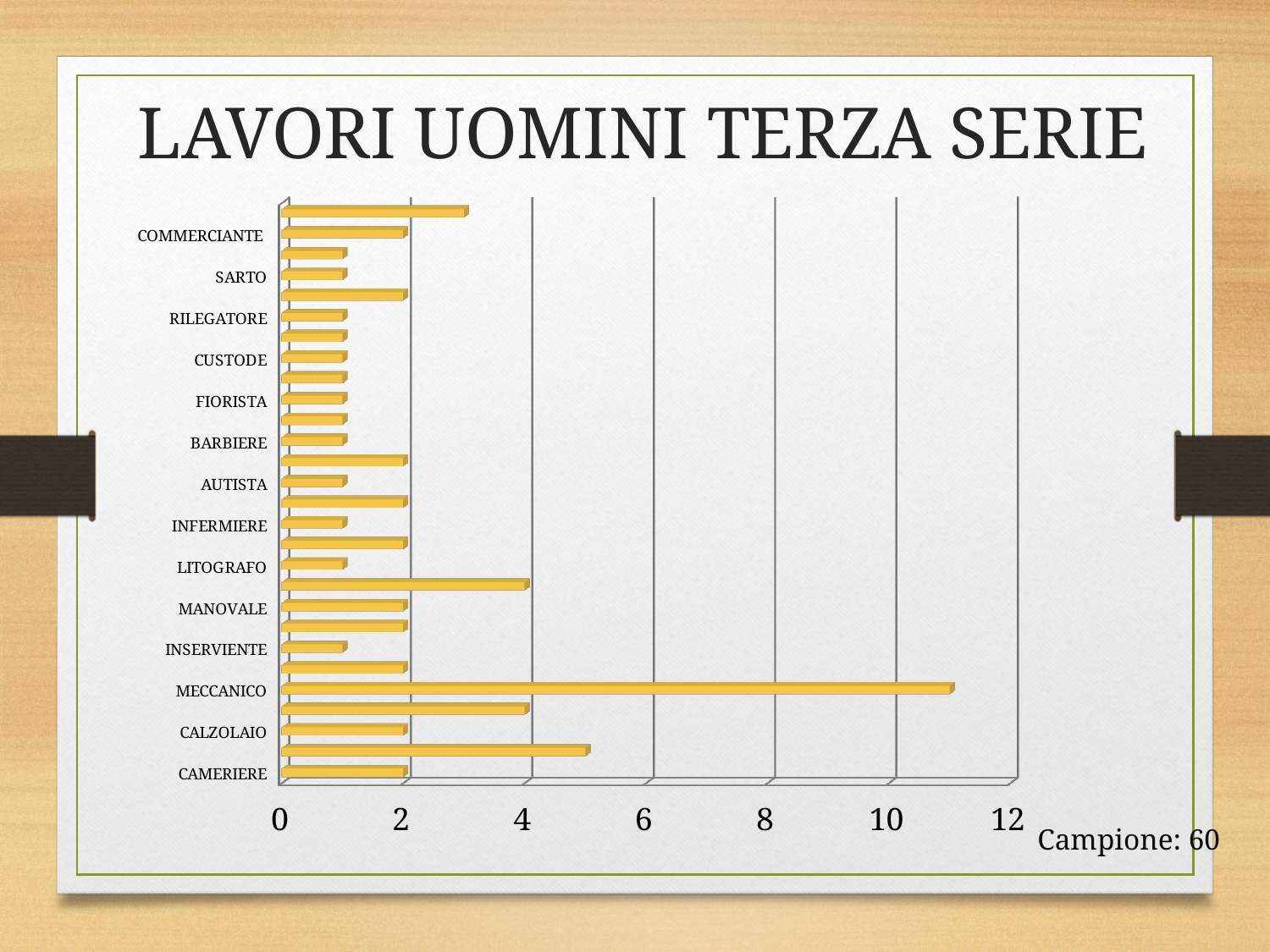
Which has a larger value, CAMERIERE or SARTO? CAMERIERE What is the value for CAMERIERE? 2 What is the highest value shown on the horizontal axis of the chart? 12 Which has a larger value, MECCANICO or CAMERIERE? MECCANICO What is the value for MANOVALE? 2 Is the value for SARTO greater or less than 2? less Is the value for CALZOLAIO greater or less than 4? less What is the title of the chart? LAVORI UOMINI TERZA SERIE Is the value for MECCANICO greater or less than 10? greater What kind of chart is shown on the slide? bar chart Which category has the highest value in the chart? MECCANICO